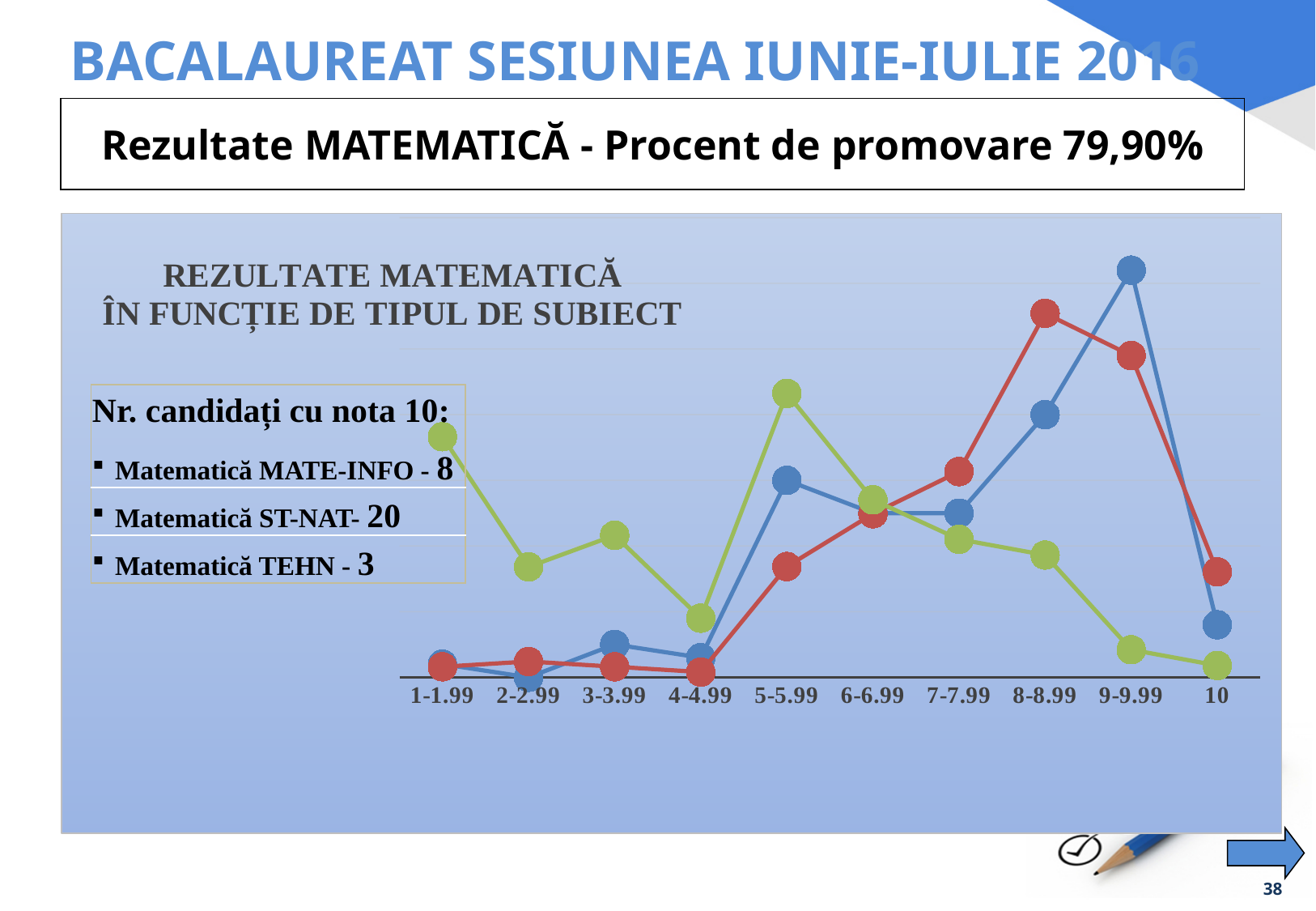
Does the green line rise or fall from the 5-5.99 interval to the 10 interval? fall In which grade interval does the green line reach its lowest point? 10 In which grade interval does the green line reach its highest point? 5-5.99 In which grade interval does the red line reach its highest point? 8-8.99 At the 5-5.99 interval, which line is higher, the green one or the blue one? green What is the title of the chart? REZULTATE MATEMATICĂ ÎN FUNCȚIE DE TIPUL DE SUBIECT In which grade interval does the blue line reach its highest point? 9-9.99 At the 9-9.99 interval, which line is higher, the blue one or the red one? blue According to the text box on the slide, how many candidates obtained grade 10 in Matematică ST-NAT? 20 How many lines (series) are plotted on the chart? 3 What kind of chart is shown on the slide? line chart How many grade-interval categories are shown on the x axis of the chart? 10